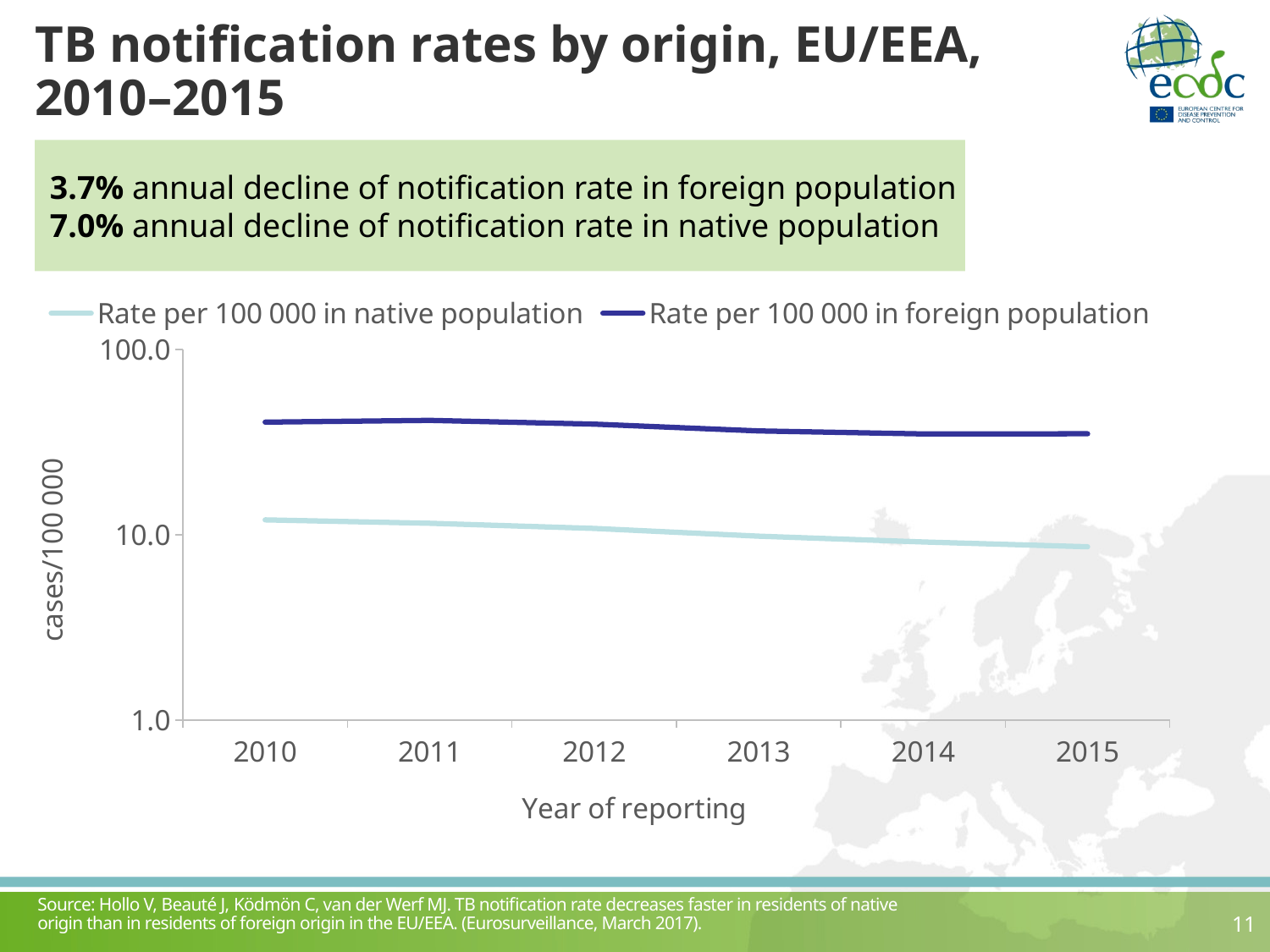
Is the rate per 100 000 in the foreign population in 2015 greater or less than 100.0? less In 2012, which series has the higher value: the native population or the foreign population? foreign population What is the label of the chart's x axis? Year of reporting Is the rate per 100 000 in the foreign population in 2010 greater or less than 10.0? greater What kind of chart is shown on the slide? line chart Which series has the lower rate per 100 000 in 2015? Rate per 100 000 in native population Does the rate per 100 000 in the native population rise or fall from 2010 to 2015? fall Does the rate per 100 000 in the foreign population rise or fall from 2010 to 2015? fall How many series does the chart's legend list? 2 What is the label of the chart's y axis? cases/100 000 How many years are plotted along the x axis of the chart? 6 Is the rate per 100 000 in the native population in 2013 greater or less than 100.0? less